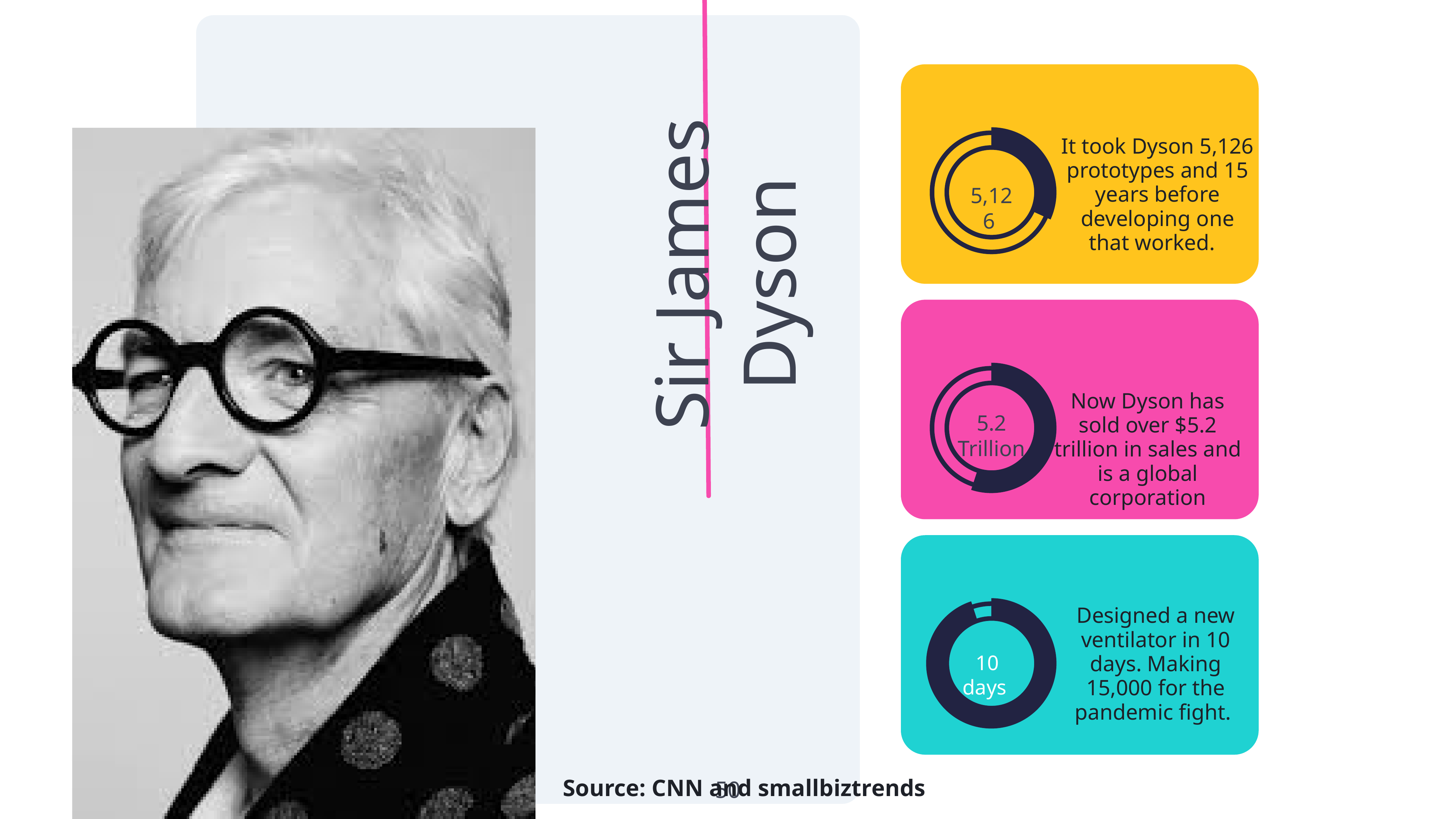
What colour is the card containing the ring chart labelled '10 days'? Teal Which ring chart is positioned at the top of the slide: the one labelled '5,126', '5.2 Trillion' or '10 days'? 5,126 What value is shown in the centre of the ring chart on the pink card? 5.2 Trillion What kind of chart is used on each of the three coloured cards? Doughnut (ring) chart What value is shown in the centre of the ring chart on the teal card? 10 days How many ring (doughnut) charts are shown on the slide? 3 What number is shown in the centre of the ring chart on the yellow card? 5,126 According to the text next to the bottom ring chart, how many ventilators were made for the pandemic fight? 15,000 Which card's ring chart shows the number of prototypes Dyson built? The yellow card (5,126) According to the text next to the top ring chart, how many years did it take Dyson to develop a working prototype? 15 years